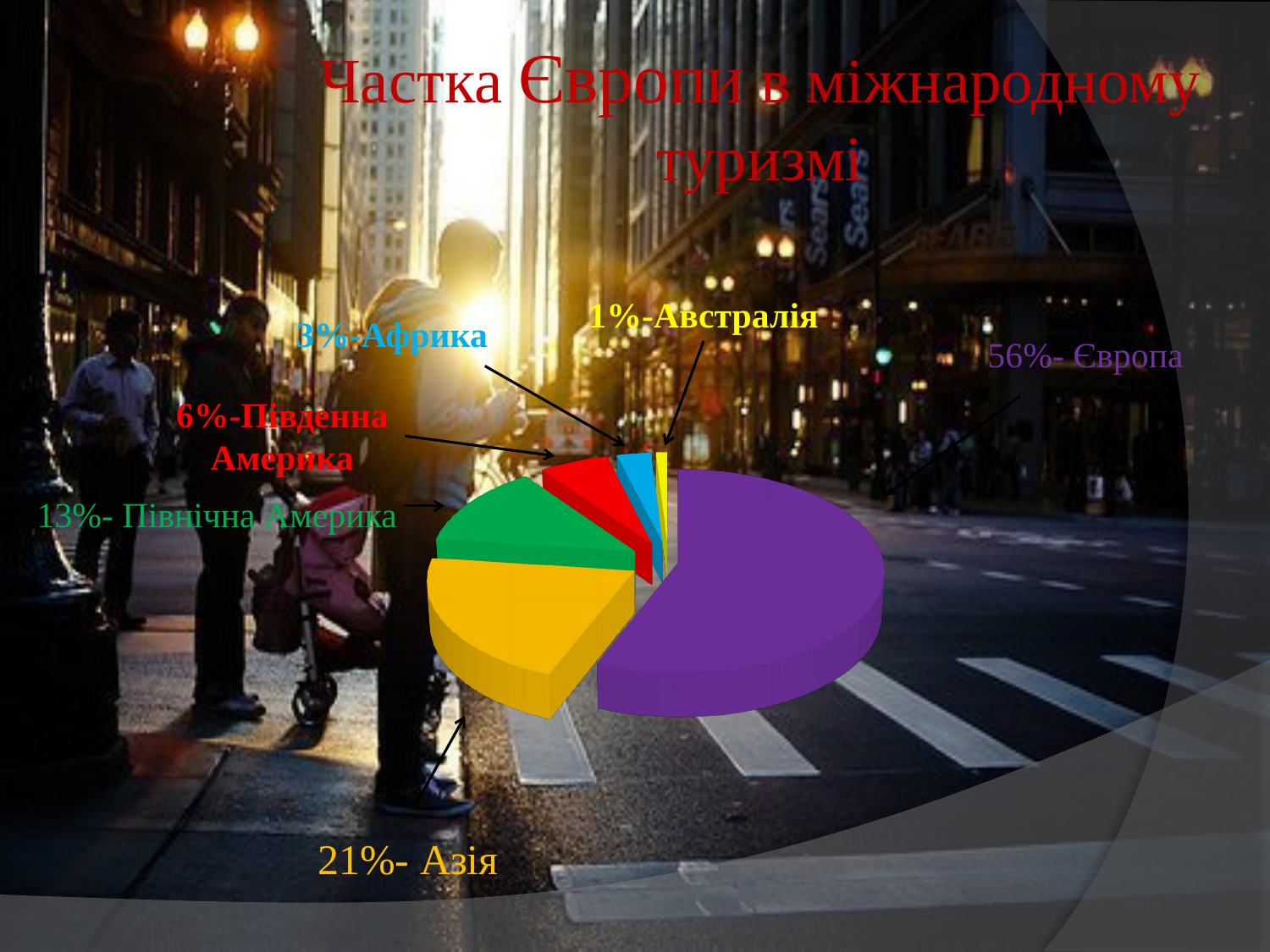
What kind of chart is shown on the slide? pie chart Which region has the largest slice in the pie chart? Європа How many slices does the pie chart have? 6 What is the share for Африка in the pie chart? 3% What is the share for Північна Америка in the pie chart? 13% What is the share for Європа in the pie chart? 56% What is the share for Азія in the pie chart? 21% What is the difference between the shares of Європа and Азія? 35% What is the share for Південна Америка in the pie chart? 6% Which region has the smallest slice in the pie chart? Австралія What is the share for Австралія in the pie chart? 1% Which has a larger share, Північна Америка or Південна Америка? Північна Америка